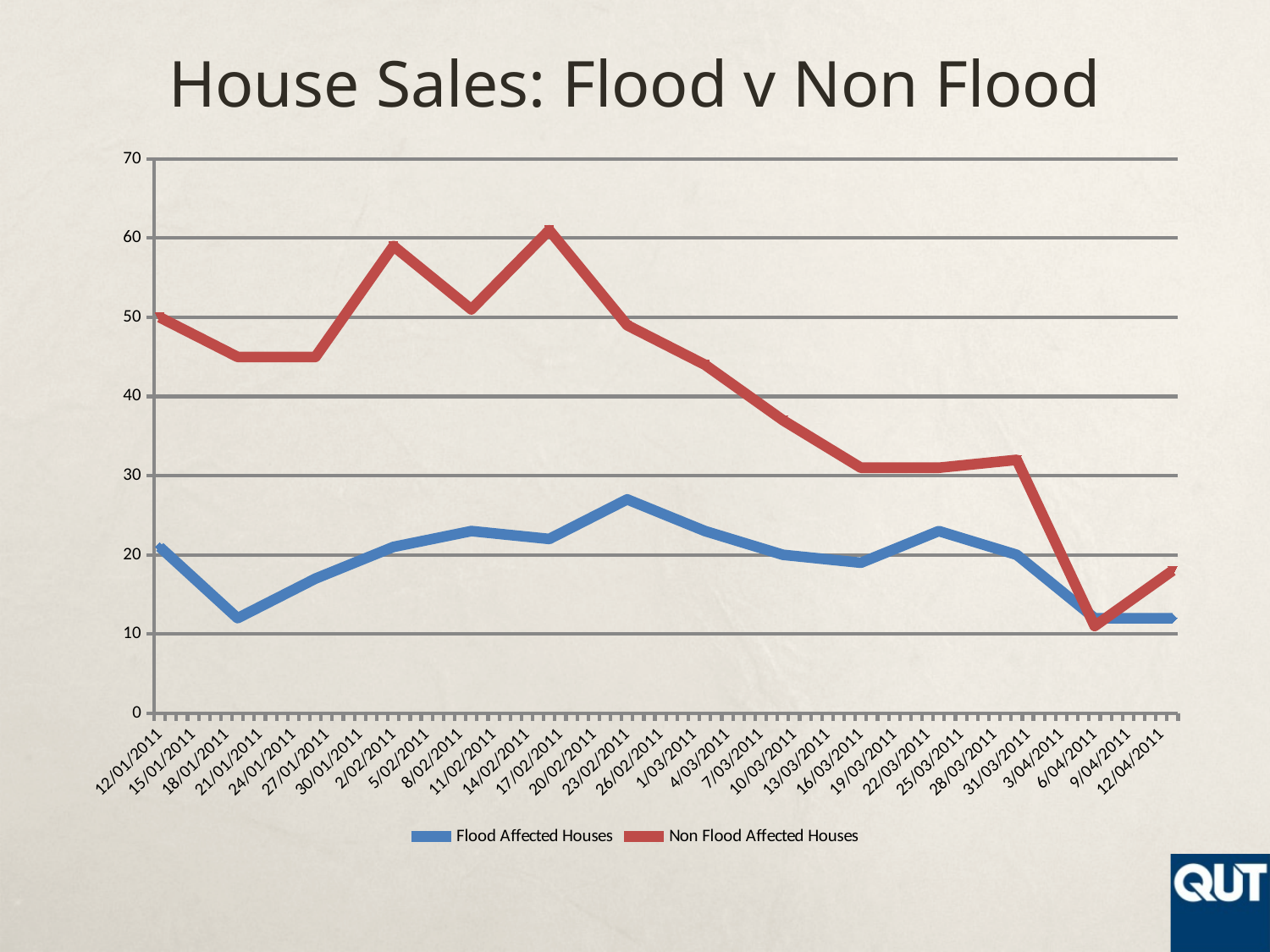
Is the value for Flood Affected Houses on 12/04/2011 greater or less than 20? less Which series reaches the highest value on the chart? Non Flood Affected Houses What kind of chart is shown on the slide? line chart What are the two series named in the legend? Flood Affected Houses and Non Flood Affected Houses On 12/01/2011, which series has the higher value, Flood Affected Houses or Non Flood Affected Houses? Non Flood Affected Houses Is the value for Non Flood Affected Houses on 17/02/2011 greater or less than 50? greater What is the title of the chart? House Sales: Flood v Non Flood Is the value for Flood Affected Houses on 12/01/2011 greater or less than 30? less Does the Non Flood Affected Houses line rise or fall between 17/02/2011 and 6/04/2011? fall On which date does the Non Flood Affected Houses line reach its lowest value? 6/04/2011 What is the value for Non Flood Affected Houses on 12/01/2011? 50 How many series does the legend list? 2